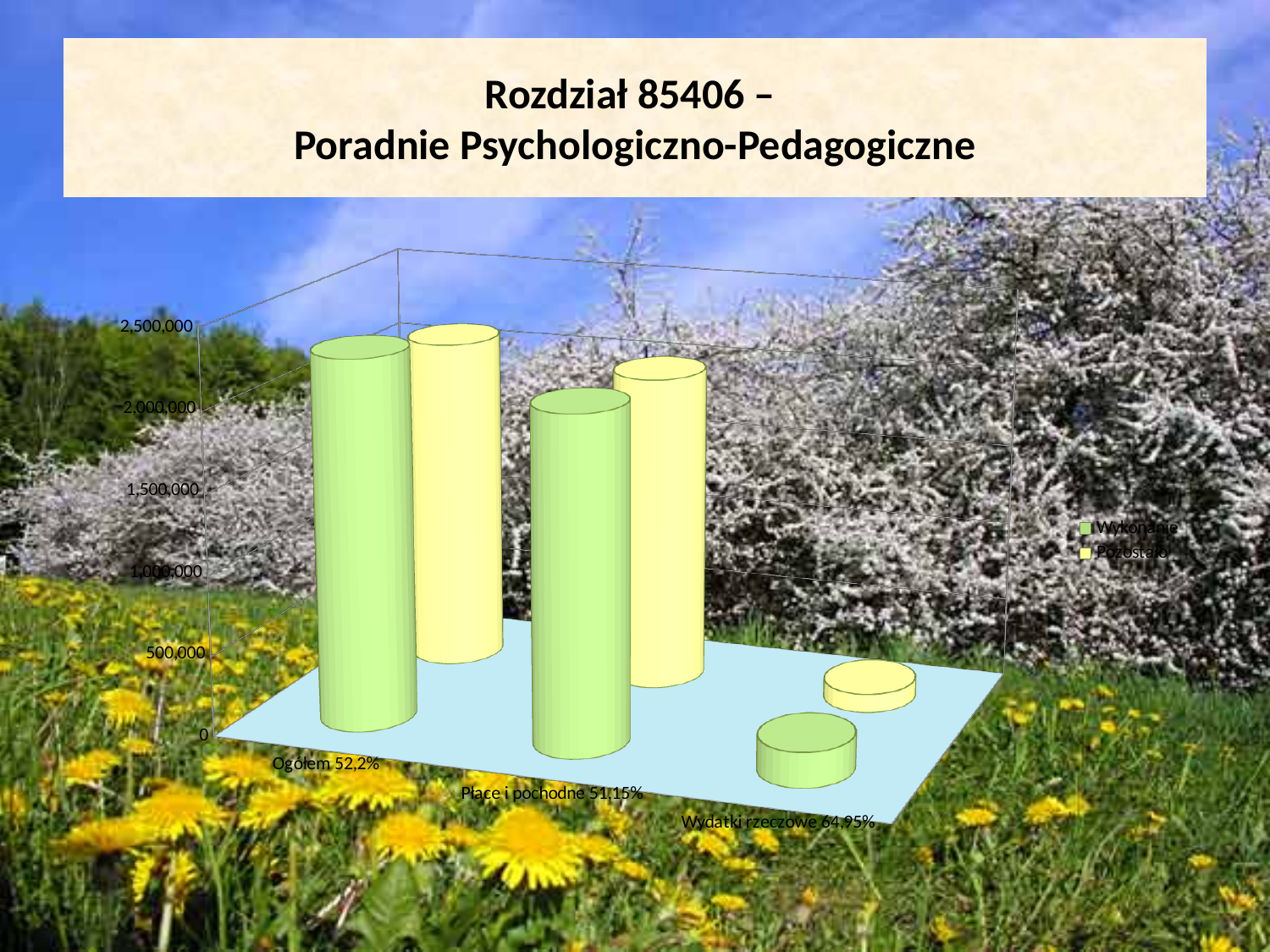
Which category has the lowest Wykonanie value? Wydatki rzeczowe Which category has the highest Wykonanie value? Ogółem Which is larger, the Pozostało value for Ogółem or the Pozostało value for Wydatki rzeczowe? Ogółem What percentage is printed next to the category label Ogółem? 52,2% What are the two series named in the chart legend? Wykonanie, Pozostało What is the title shown at the top of the slide? Rozdział 85406 – Poradnie Psychologiczno-Pedagogiczne What percentage is printed next to the category label Wydatki rzeczowe? 64,95% How many categories are shown on the x axis of the chart? 3 Is the Wykonanie value for Wydatki rzeczowe greater or less than 500,000? less Is the Wykonanie value for Ogółem greater or less than 1,500,000? greater What kind of chart is shown on the slide? bar chart How many series does the chart legend list? 2